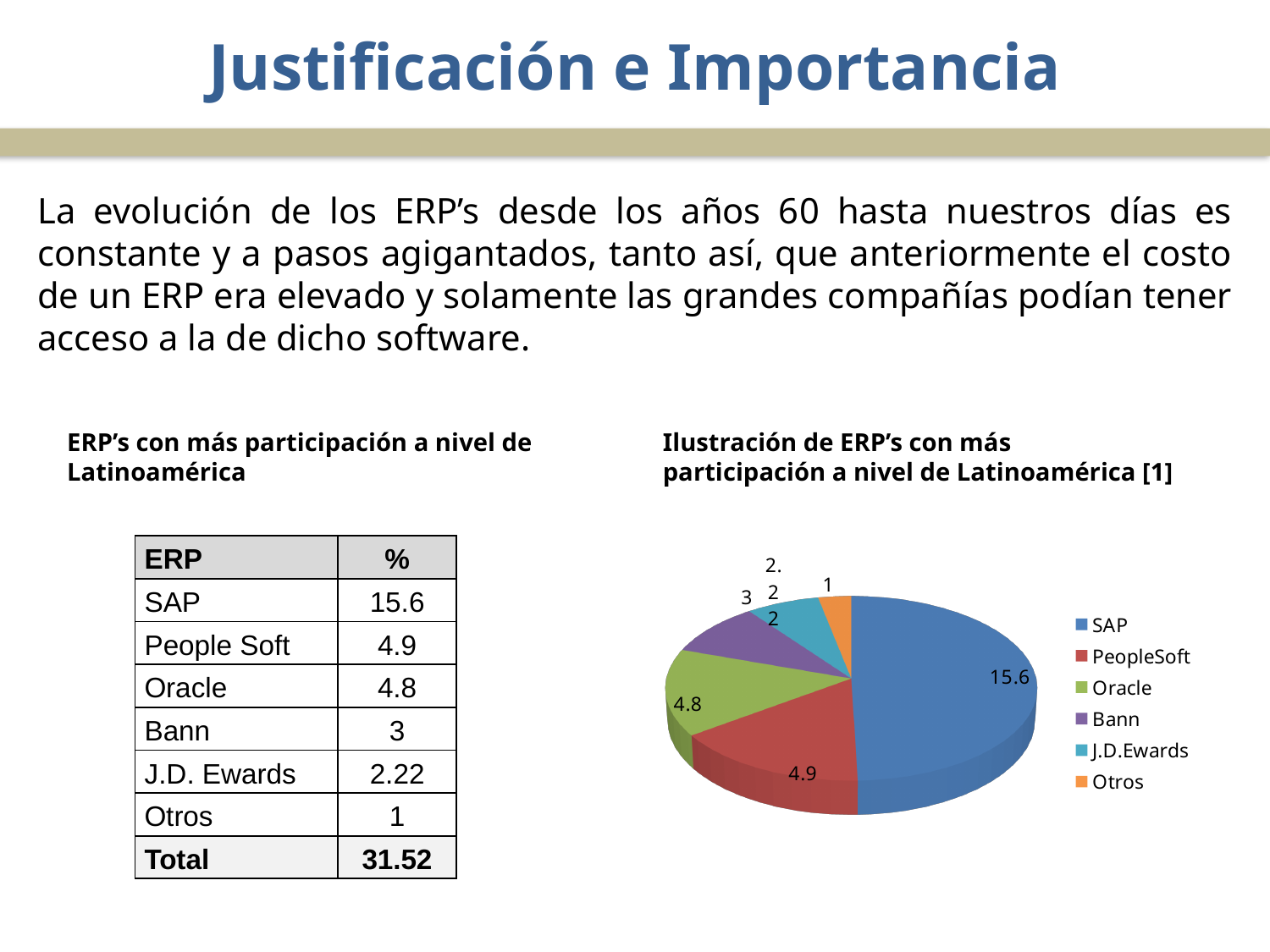
What value is shown for the PeopleSoft slice in the pie chart? 4.9 How many entries does the pie chart's legend list? 6 What kind of chart is shown on the slide? Pie chart Which category has the smallest slice in the pie chart? Otros Which is larger in the pie chart, the Bann slice or the Otros slice? Bann Which category has the largest slice in the pie chart? SAP What value is shown for the Bann slice in the pie chart? 3 What value is shown for the Oracle slice in the pie chart? 4.8 What value is shown for the Otros slice in the pie chart? 1 What value is shown for the SAP slice in the pie chart? 15.6 What is the difference between the SAP value and the PeopleSoft value in the pie chart? 10.7 How many slices does the pie chart have? 6